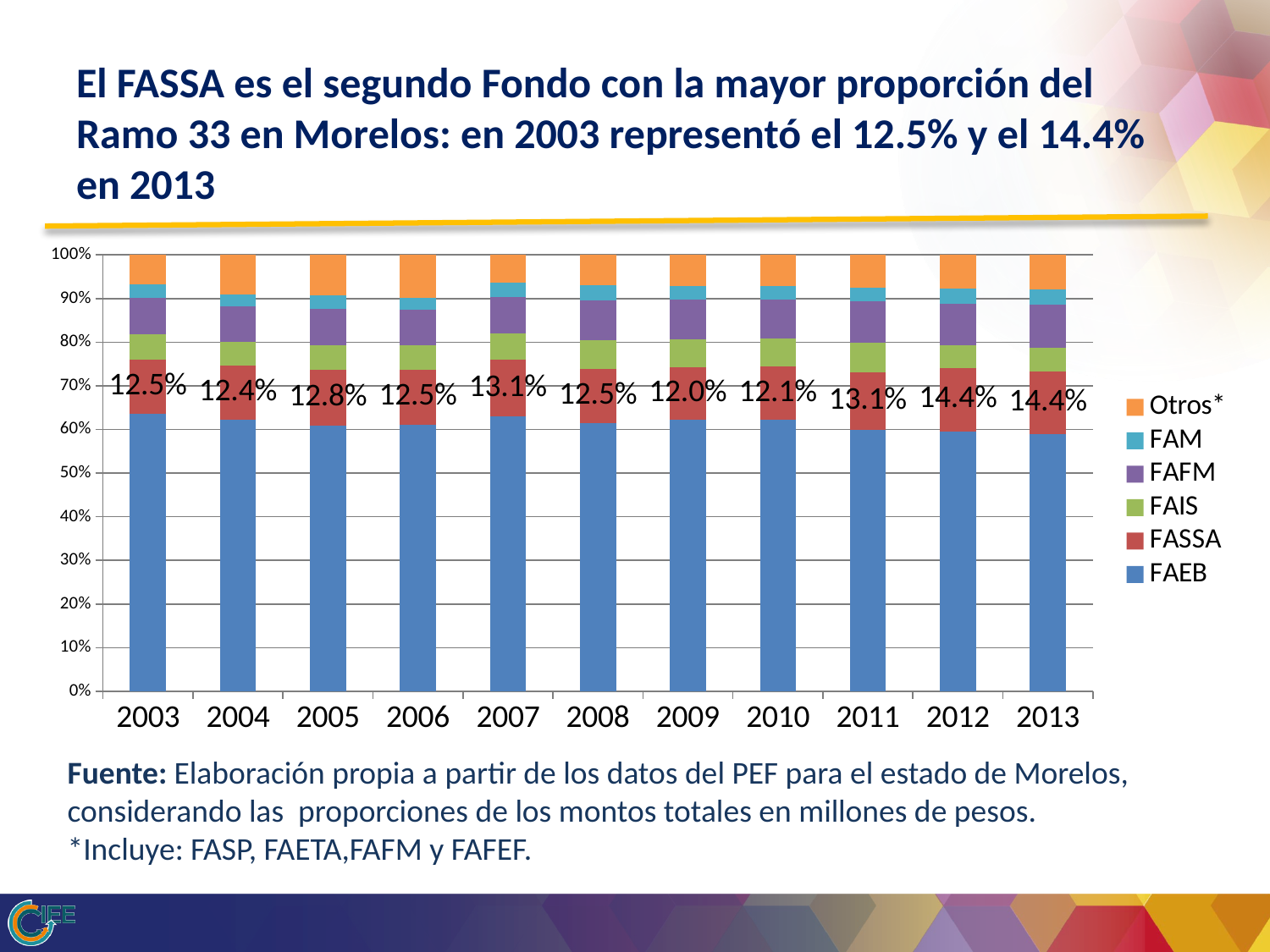
Which series is plotted at the bottom of each stacked bar? FAEB What is the FASSA share in 2013? 14.4% What kind of chart is shown on the slide? stacked bar chart How many years are shown on the x axis of the chart? 11 Is the FAEB share in 2003 greater or less than 60%? greater What is the FASSA share in 2003? 12.5% How many series does the chart legend list? 6 By how many percentage points did the FASSA share change from 2003 to 2013? 1.9% Which legend entry is marked with an asterisk? Otros* In which year is the labelled FASSA share the lowest? 2009 What is the FASSA share in 2009? 12.0% Which year has a larger FASSA share, 2007 or 2010? 2007